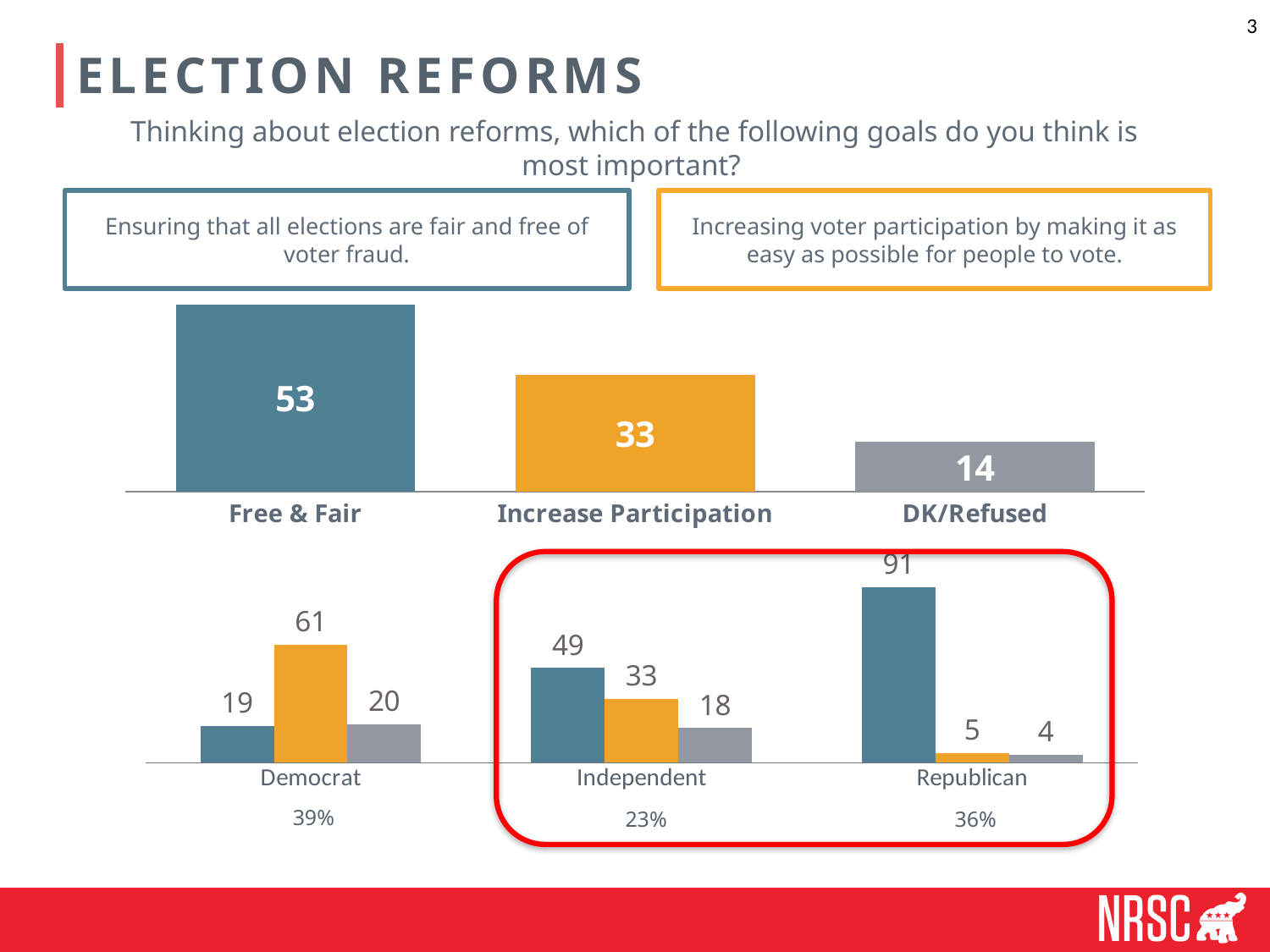
In the top chart, what is the difference between Free & Fair and Increase Participation? 20 In the top chart, what is the value for DK/Refused? 14 What kind of chart is the top chart? Bar chart In the bottom chart, what is the value of the gray bar for Independent? 18 How many categories are shown in the top chart? 3 In the top chart, which category has the highest value? Free & Fair In the bottom chart, what is the value of the orange bar for Democrat? 61 In the bottom chart, which is larger for Independent: the teal bar or the orange bar? The teal bar In the bottom chart, which party group has the lowest orange bar? Republican In the bottom chart, what percentage is shown beneath the Democrat group? 39% In the top chart, what is the value for Free & Fair? 53 In the bottom chart, what is the value of the teal bar for Republican? 91